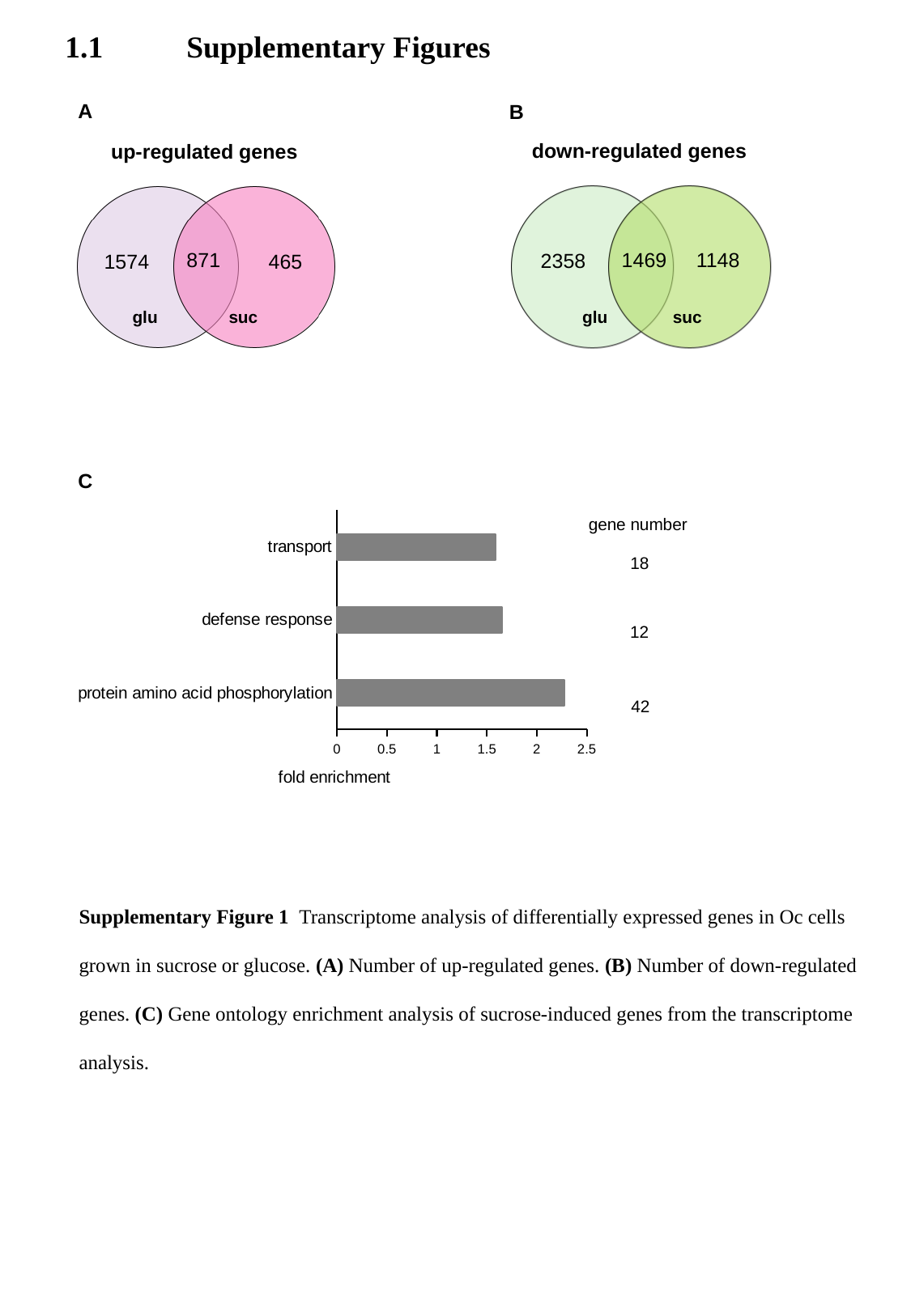
In chart C, how many categories are plotted? 3 In chart C, is the fold enrichment for transport greater or less than 2? less In chart C, is the fold enrichment for protein amino acid phosphorylation greater or less than 2? greater In chart C, which category has the highest fold enrichment? protein amino acid phosphorylation In chart C, what is the gene number listed for protein amino acid phosphorylation? 42 In chart C, what kind of chart is shown? bar chart In chart C, what is the label on the horizontal axis? fold enrichment In chart C, is the fold enrichment for defense response greater or less than 1? greater In chart C, what is the gene number listed for transport? 18 In chart C, which has the larger fold enrichment, transport or protein amino acid phosphorylation? protein amino acid phosphorylation In chart C, what is the gene number listed for defense response? 12 In the up-regulated genes diagram (A), how many genes are shared between glu and suc? 871